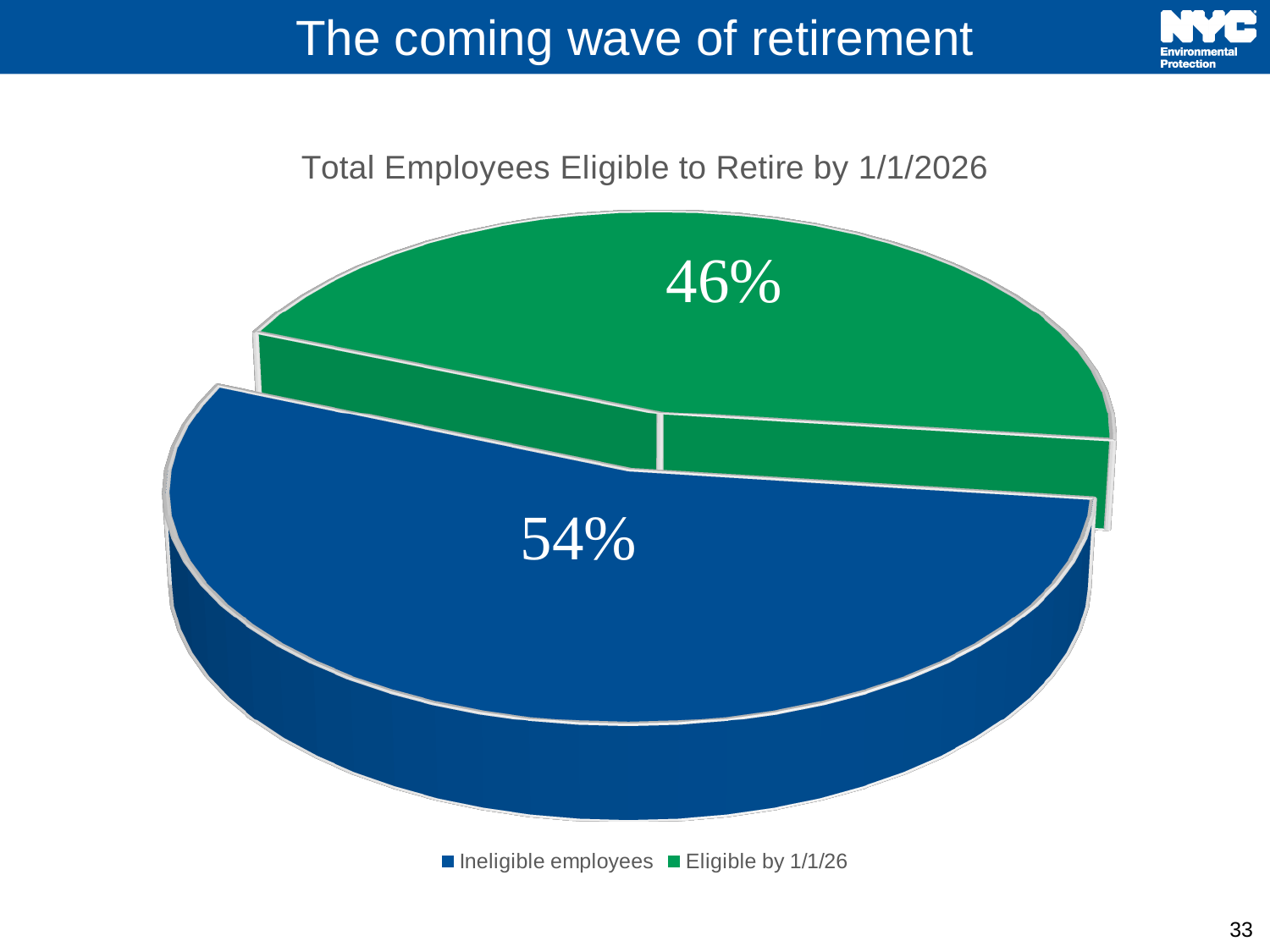
What is the difference in percentage points between the 'Ineligible employees' slice and the 'Eligible by 1/1/26' slice? 8 What share of the pie is labelled 'Eligible by 1/1/26'? 46% Is the share for 'Eligible by 1/1/26' greater or less than 50%? less Which slice of the pie is the largest? Ineligible employees How many entries does the legend list? 2 Which is larger: the 'Ineligible employees' slice or the 'Eligible by 1/1/26' slice? Ineligible employees What kind of chart is shown on the slide? Pie chart What share of the pie is labelled 'Ineligible employees'? 54% Which slice of the pie is the smallest? Eligible by 1/1/26 What colour is the 'Eligible by 1/1/26' slice? Green How many slices does the pie chart have? 2 What is the title of the chart? Total Employees Eligible to Retire by 1/1/2026